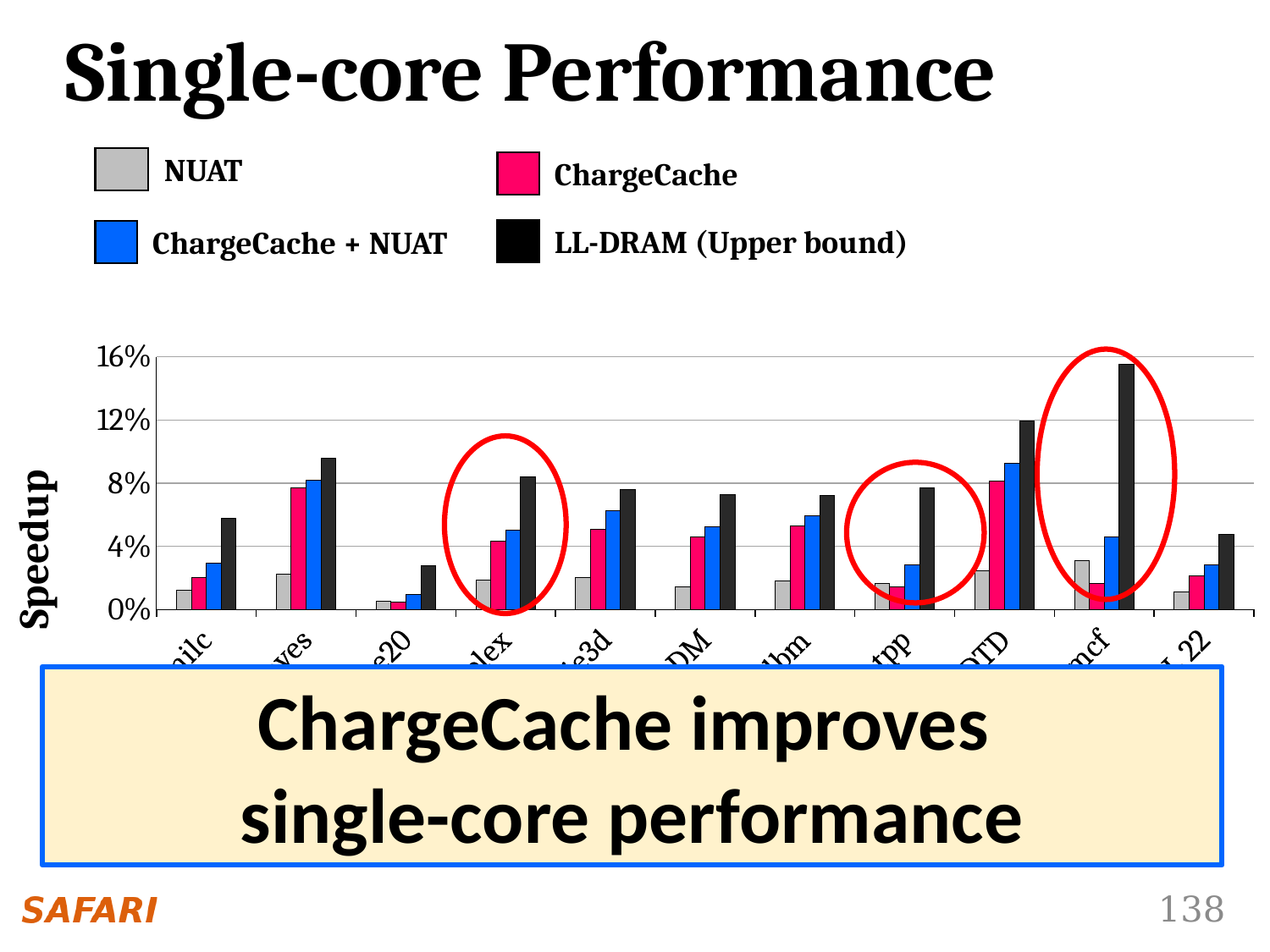
Is the ChargeCache value for the second category group greater or less than 4%? greater In the first category group, which is larger: the ChargeCache bar or the ChargeCache + NUAT bar? ChargeCache + NUAT Which series has the tallest bar in every category group? LL-DRAM (Upper bound) Is the LL-DRAM (Upper bound) value for the tenth category group (the rightmost red-circled group) greater or less than 12%? greater Which series is drawn in black in the legend? LL-DRAM (Upper bound) Is the NUAT value for the third category group greater or less than 4%? less What is the label of the y axis? Speedup In the tenth category group (the rightmost red-circled group), which is larger: the NUAT bar or the ChargeCache bar? NUAT How many category groups (benchmarks) are plotted along the x axis? 11 How many series does the legend list? 4 What kind of chart is shown on the slide? bar chart